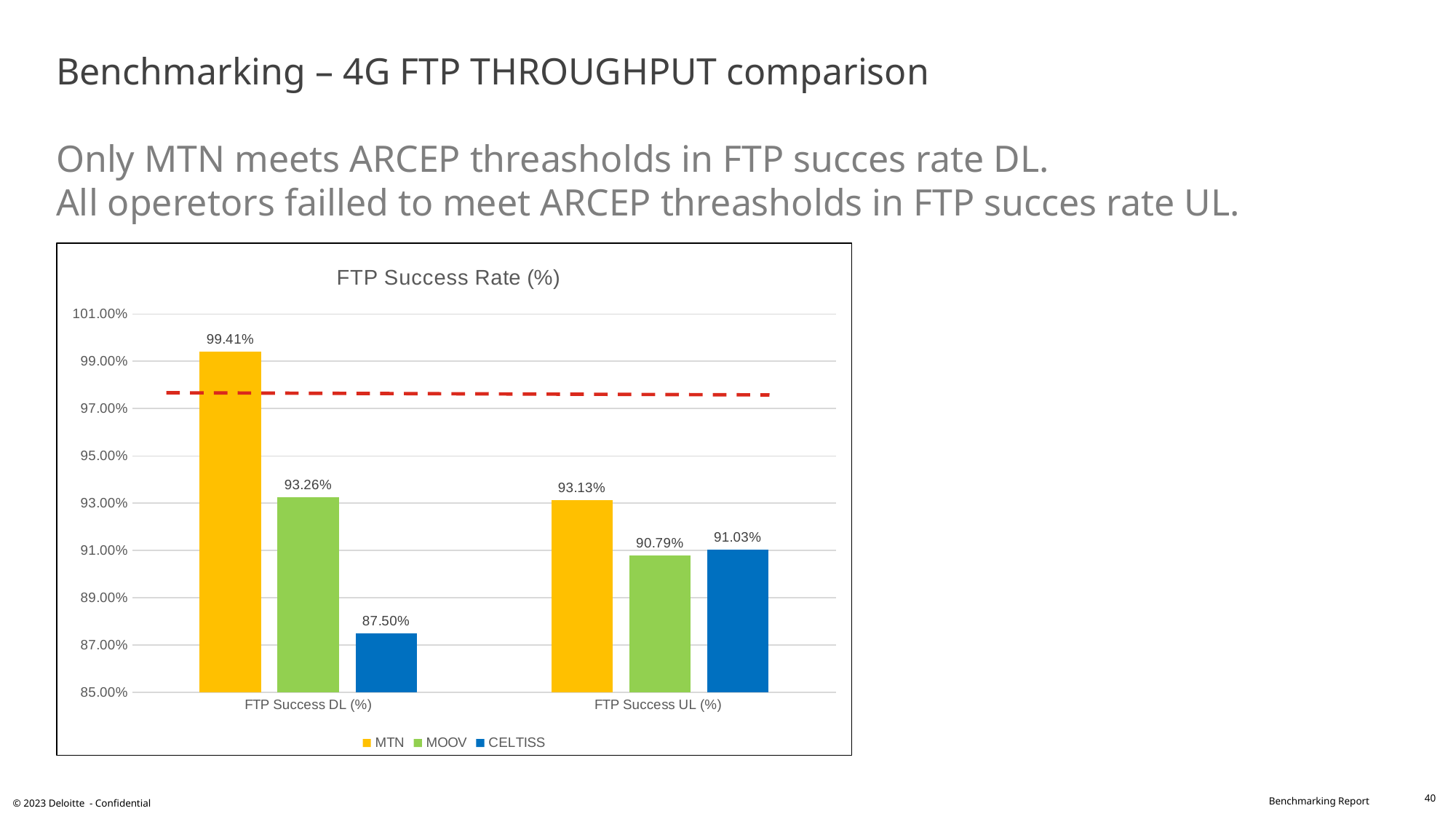
What is the difference between MTN's FTP Success DL (%) and FTP Success UL (%) values? 6.28 percentage points What is the FTP Success DL (%) value for MOOV? 93.26% What is the FTP Success UL (%) value for CELTISS? 91.03% Which operator has the highest FTP Success DL (%)? MTN What kind of chart is shown on the slide? Bar chart What is the title of the chart? FTP Success Rate (%) What is the difference between MTN's and CELTISS's FTP Success DL (%) values? 11.91 percentage points Which is larger: MOOV's FTP Success DL (%) or MOOV's FTP Success UL (%)? FTP Success DL (%) Which operator has the lowest FTP Success UL (%)? MOOV Is the FTP Success DL (%) value for CELTISS greater or less than 89.00%? less How many series does the legend list? 3 What is the FTP Success DL (%) value for MTN? 99.41%